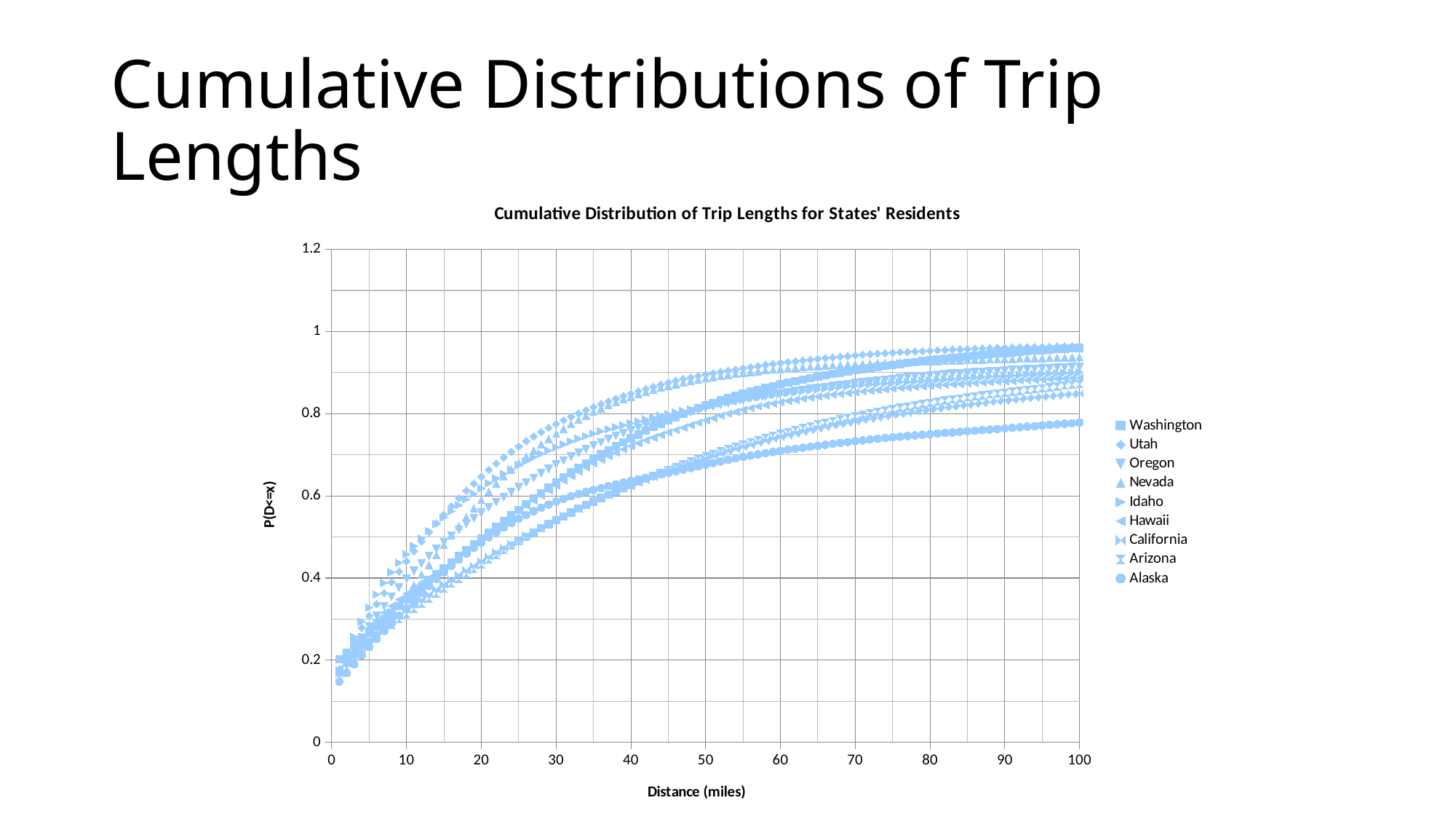
Is the value for Utah at 100 miles greater or less than 0.9? greater Is the value for Alaska at 50 miles greater or less than 0.8? less What is the title of the chart? Cumulative Distribution of Trip Lengths for States' Residents What is the label of the x axis? Distance (miles) Which state has the lowest value at 100 miles? Alaska At 100 miles, which is larger, the value for Utah or the value for Alaska? Utah Do the values for each state rise or fall as distance increases along the x axis? rise Is the value for Utah at 30 miles greater or less than 0.6? greater How many series does the legend list? 9 What kind of chart is shown on the slide? scatter chart What is the highest value shown on the y axis? 1.2